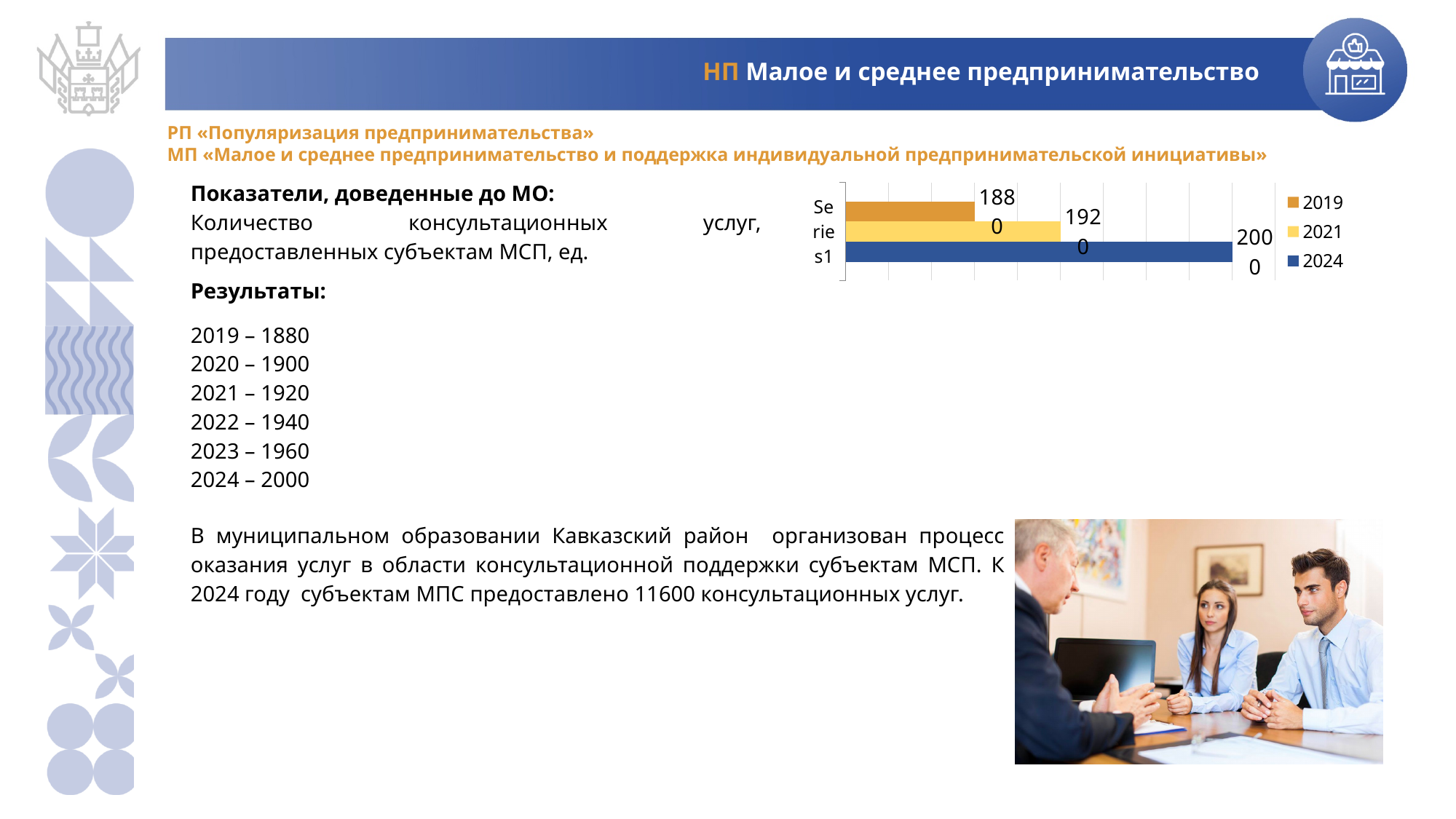
Which is larger in the bar chart, the value for 2021 or the value for 2024? 2024 How many series does the legend of the bar chart list? 3 What kind of chart is shown on the slide? bar chart Which series has the highest value in the bar chart? 2024 What is the difference between the 2021 value and the 2019 value in the bar chart? 40 What is the difference between the 2024 value and the 2019 value in the bar chart? 120 What value is shown for the 2024 series in the bar chart? 2000 Which series is shown in orange in the bar chart? 2019 What value is shown for the 2019 series in the bar chart? 1880 What value is shown for the 2021 series in the bar chart? 1920 Which series is shown in dark blue in the bar chart? 2024 Which series has the lowest value in the bar chart? 2019